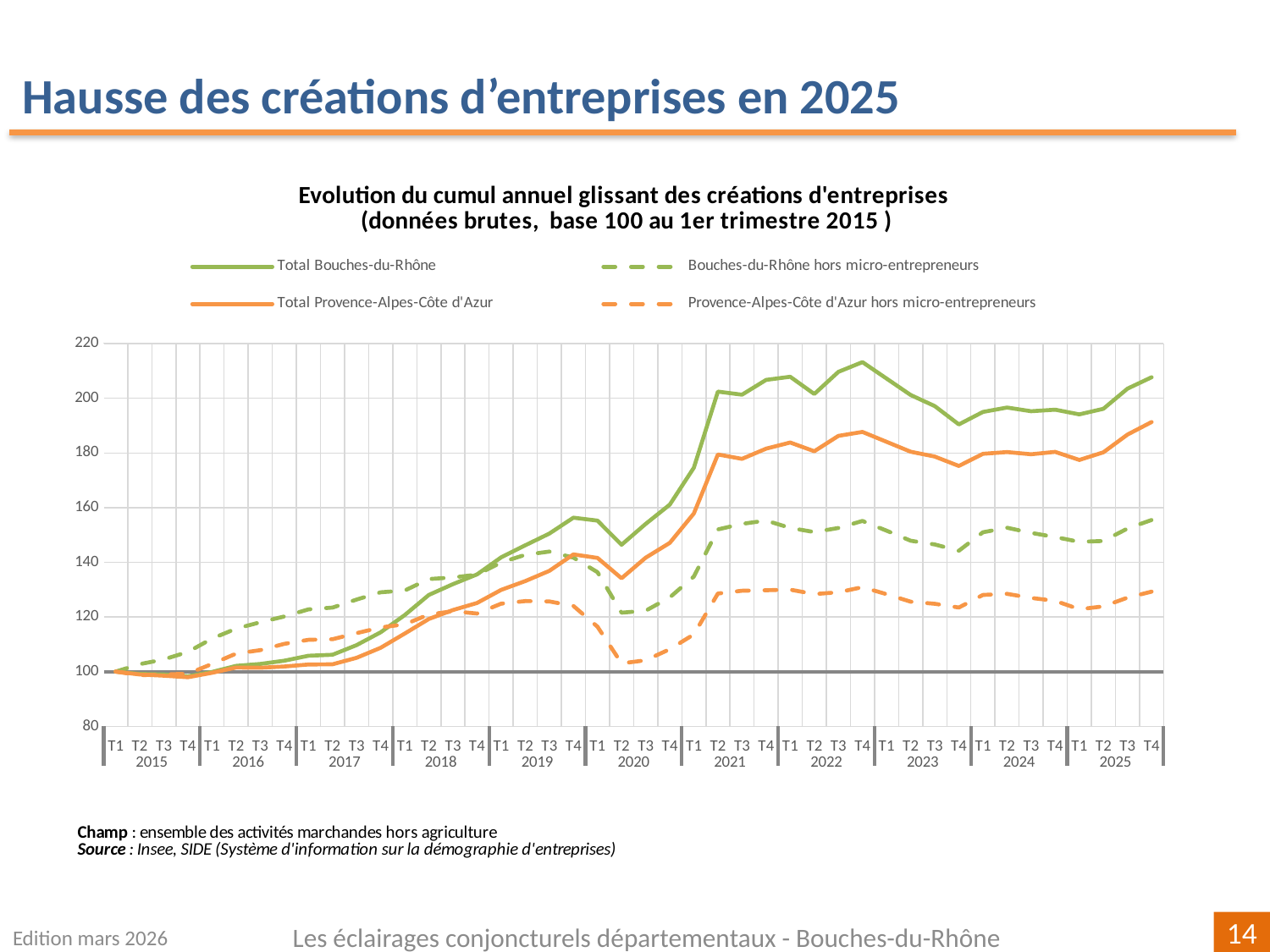
What is the value of every series at T1 2015, the base period? 100 How many series does the legend list? 4 Is the value for Bouches-du-Rhône hors micro-entrepreneurs at T4 2025 greater or less than 160? less Is the value for Total Bouches-du-Rhône at T4 2025 greater or less than 200? greater At T4 2025, which is higher: Total Bouches-du-Rhône or Total Provence-Alpes-Côte d'Azur? Total Bouches-du-Rhône Is the value for Total Provence-Alpes-Côte d'Azur at T4 2025 greater or less than 180? greater What is the title of the chart? Evolution du cumul annuel glissant des créations d'entreprises (données brutes, base 100 au 1er trimestre 2015) What kind of chart is shown on the slide? Line chart How many years are shown along the x axis? 11 Overall, does the Total Bouches-du-Rhône series rise or fall between T1 2015 and T4 2025? Rise Which series has the lowest value at T4 2025? Provence-Alpes-Côte d'Azur hors micro-entrepreneurs